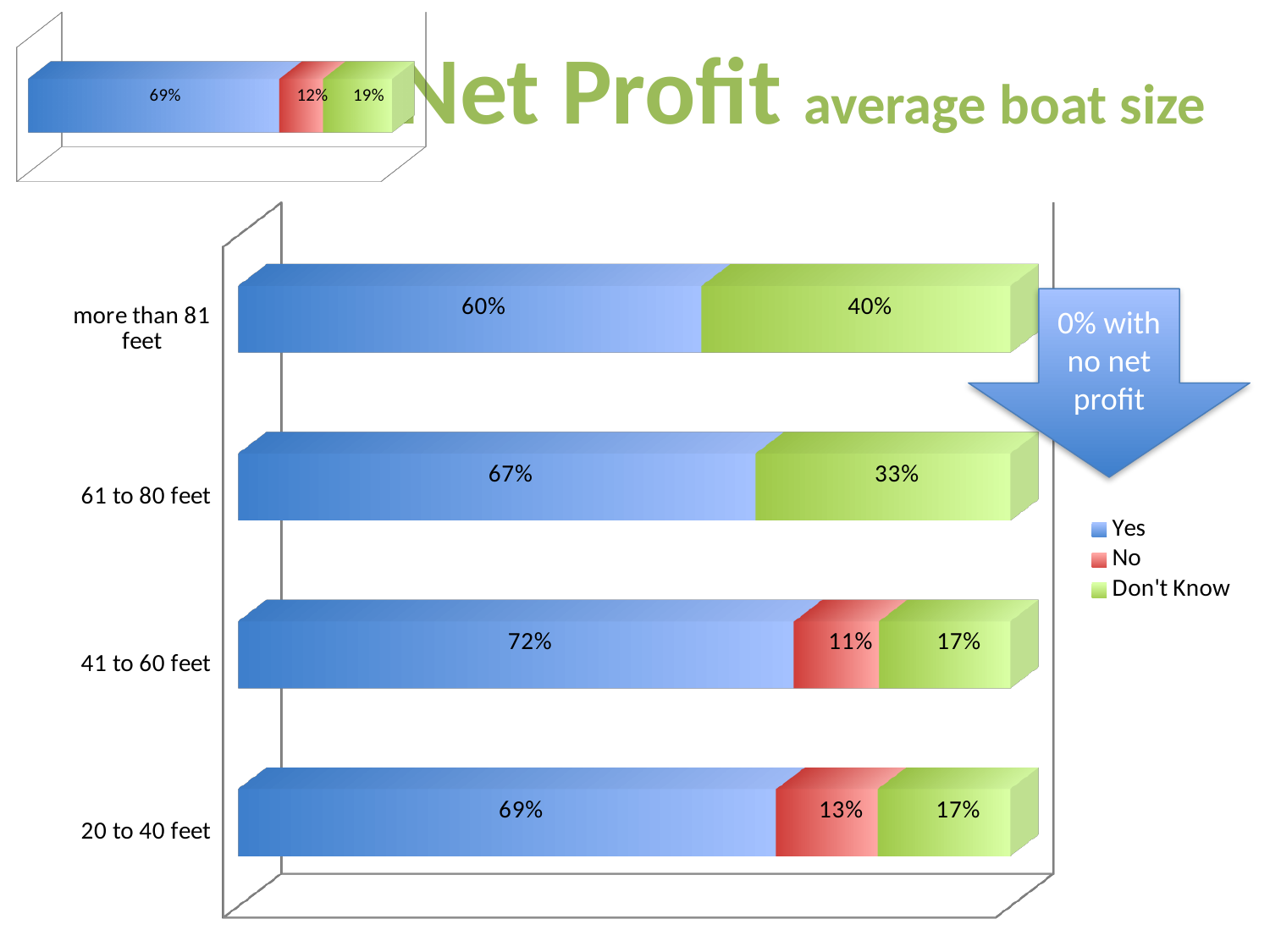
In the main chart, which colour represents the 'No' series? Red In the main chart, which boat size category has the highest 'Yes' value? 41 to 60 feet How many boat size categories does the main chart show? 4 In the main chart, what is the 'Yes' value for 41 to 60 feet? 72% How many series does the legend of the main chart list? 3 In the main chart, what is the 'No' value for 20 to 40 feet? 13% What kind of chart is the main chart on the slide? Stacked bar chart In the main chart, which is larger: the 'Don't Know' value for 61 to 80 feet or for 41 to 60 feet? 61 to 80 feet In the main chart, what is the 'Don't Know' value for more than 81 feet? 40% In the small chart at the top-left of the slide, what is the value of the red segment? 12% In the main chart, what is the difference between the 'Yes' values for 41 to 60 feet and 20 to 40 feet? 3% In the main chart, which boat size category has the lowest 'Yes' value? more than 81 feet